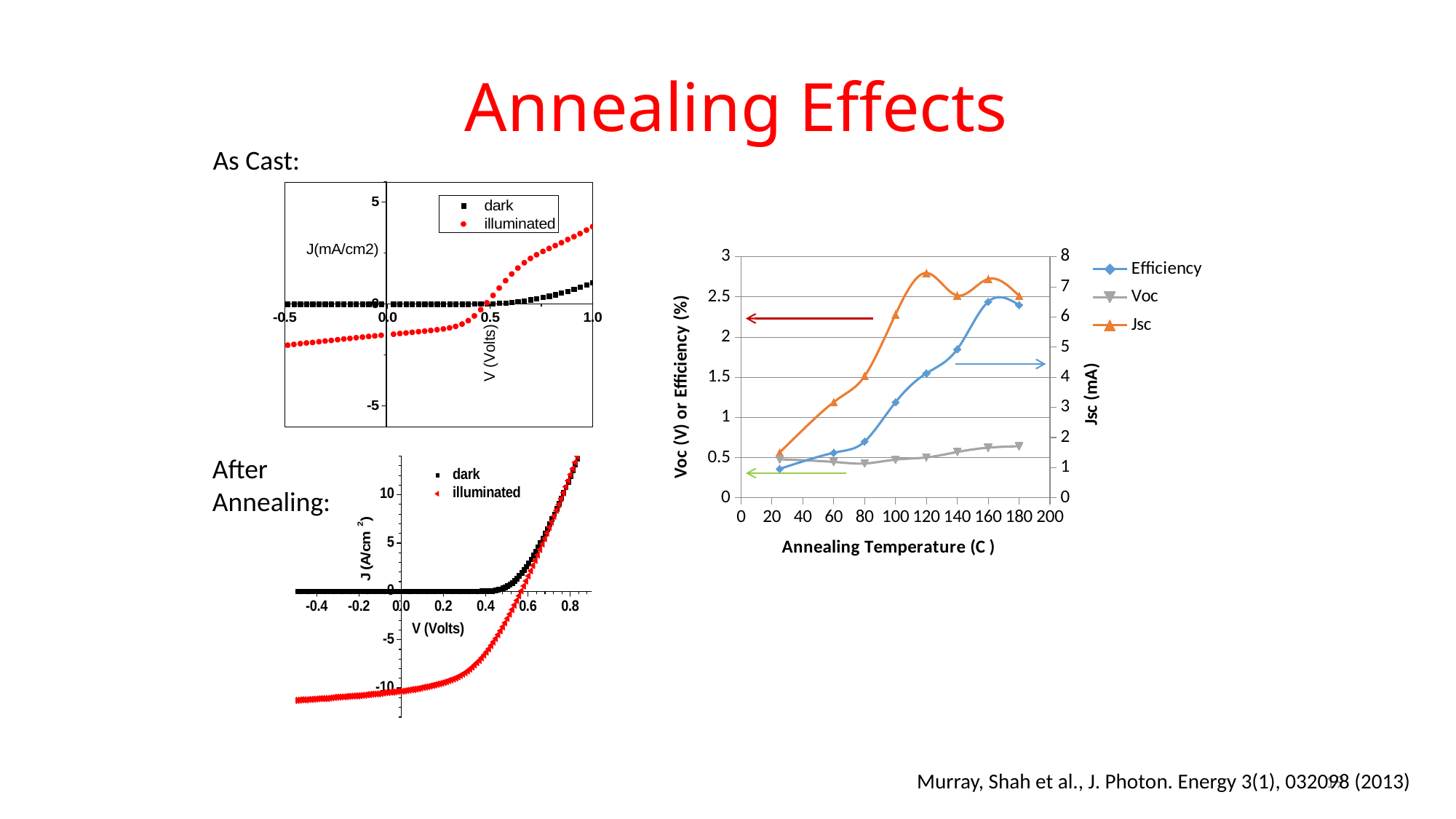
On the right-hand chart (Annealing Temperature), at which annealing temperature is Efficiency highest? 160 On the right-hand chart (Annealing Temperature), is the Jsc value at 25 greater or less than 2 on the right axis? less On the right-hand chart (Annealing Temperature), does the Efficiency series generally rise or fall as annealing temperature increases from 25 to 160? rise On the 'As Cast' chart at the top left, how many series does the legend list? 2 On the right-hand chart (Annealing Temperature), is the Efficiency value at 160 greater or less than 2? greater On the right-hand chart (Annealing Temperature), is the Efficiency value at 25 greater or less than 0.5? less On the right-hand chart (Annealing Temperature), at which annealing temperature is Jsc highest? 120 On the right-hand chart (Annealing Temperature), what is the label of the x axis? Annealing Temperature (C ) On the right-hand chart (Annealing Temperature), how many series does the legend list? 3 On the right-hand chart (Annealing Temperature), which is larger, the Efficiency at 100 or the Efficiency at 140? Efficiency at 140 On the right-hand chart (Annealing Temperature), what are the series named in the legend? Efficiency, Voc, Jsc